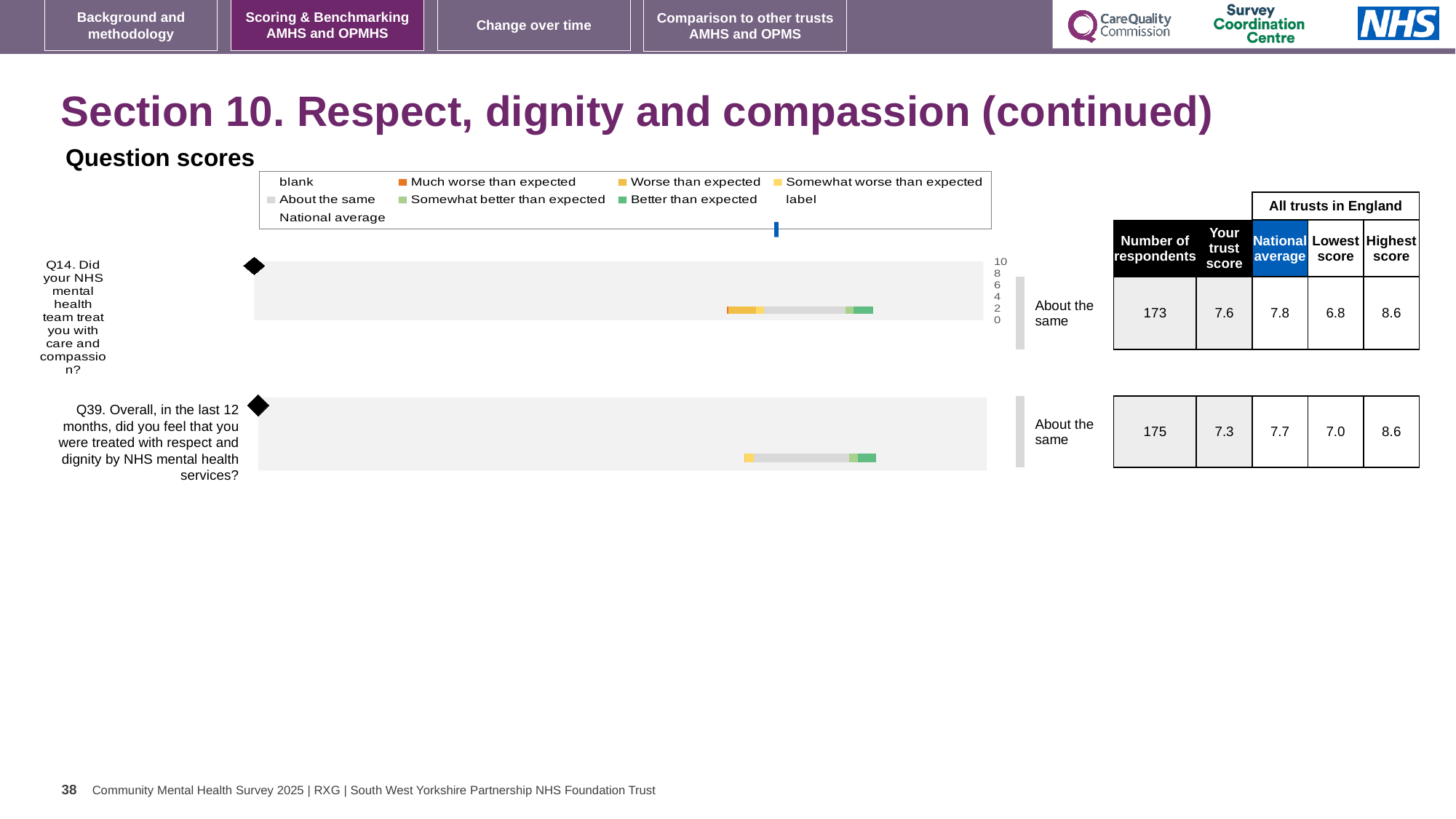
What kind of chart is used to show the question scores on this slide? bar chart What is the lowest score among all trusts in England for Q39? 7.0 Which question has the higher trust score, Q14 or Q39? Q14 What is the national average for Q14? 7.8 What benchmark category is shown next to the Q14 bar? About the same How many respondents answered Q39? 175 What is the difference between the national average and the trust score for Q14? 0.2 How many questions are plotted in the question scores chart? 2 What is the trust score for Q14 (care and compassion)? 7.6 What is the trust score for Q39 (respect and dignity)? 7.3 What is the difference between the highest and lowest scores for Q39? 1.6 Which legend entry is shown in orange? Much worse than expected